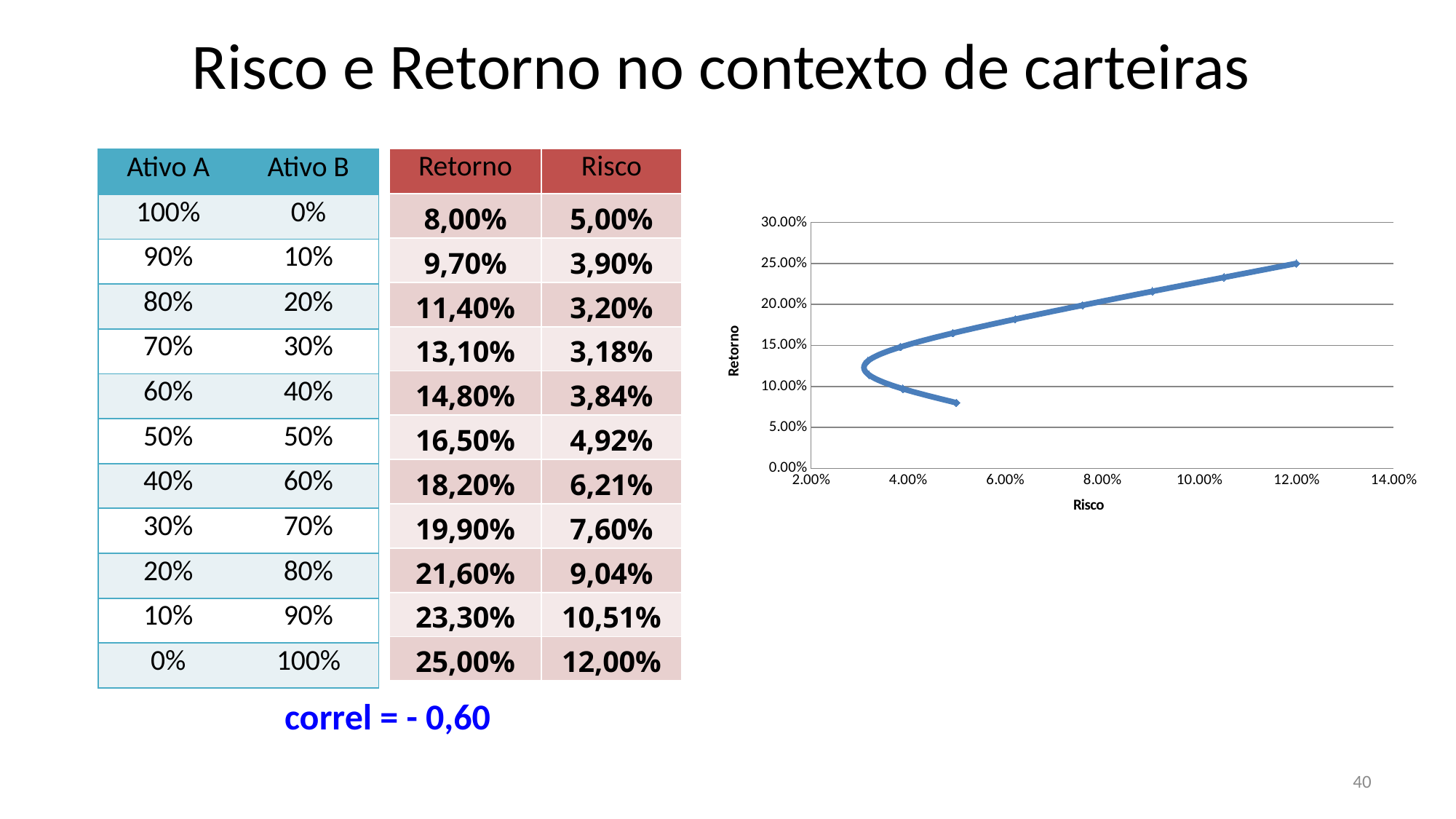
Is the risk (Risco) of the rightmost point on the curve greater or less than 10.00%? greater Along the upper branch of the curve, does Retorno rise or fall as Risco increases? rises Is the return (Retorno) of the lowest plotted point greater or less than 10.00%? less Is the risk (Risco) of the leftmost point on the curve greater or less than 4.00%? less What kind of chart is shown on the right of the slide? scatter chart What is the label of the horizontal axis of the chart? Risco How many data points are plotted on the chart? 11 According to the table, what is the lowest Risco value plotted on the chart? 3,18% What is the label of the vertical axis of the chart? Retorno According to the table, what is the highest Retorno value plotted on the chart? 25,00% Which point has the higher Retorno: the one at Risco 12,00% or the one at Risco 5,00%? the one at Risco 12,00%